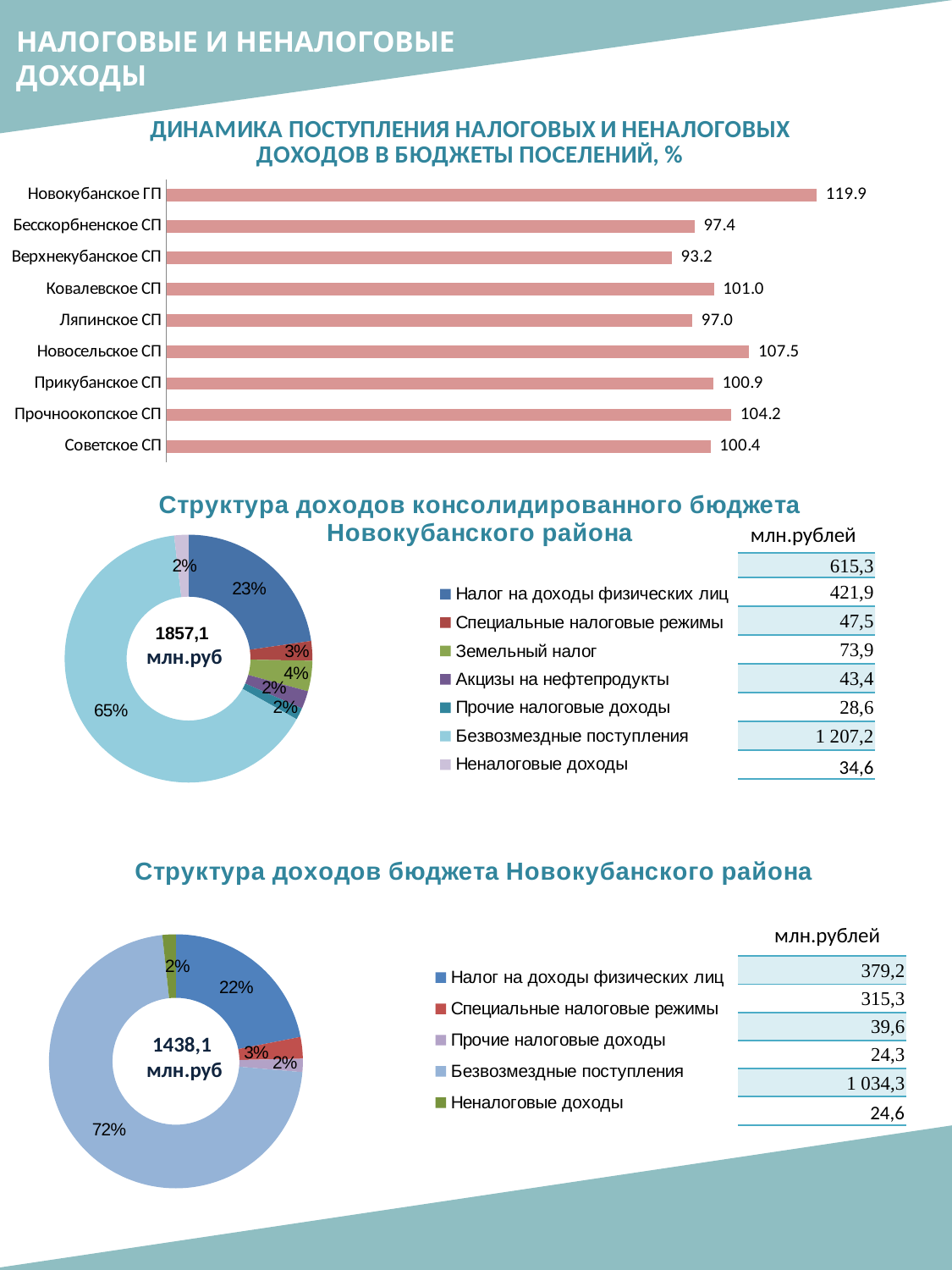
How many settlements are shown in the top bar chart? 9 In the top bar chart, which is larger: the value for Ковалевское СП or for Ляпинское СП? Ковалевское СП How many entries does the legend of the doughnut chart 'Структура доходов бюджета Новокубанского района' list? 5 In the doughnut chart 'Структура доходов бюджета Новокубанского района', what share do Безвозмездные поступления have? 72% What kind of chart is the top chart titled 'ДИНАМИКА ПОСТУПЛЕНИЯ НАЛОГОВЫХ И НЕНАЛОГОВЫХ ДОХОДОВ В БЮДЖЕТЫ ПОСЕЛЕНИЙ, %'? bar chart In the top bar chart, which settlement has the lowest value? Верхнекубанское СП In the top bar chart, what is the value for Новокубанское ГП? 119.9 In the top bar chart, what is the difference between the values for Новосельское СП and Прочноокопское СП? 3.3 What total value is shown in the centre of the doughnut chart 'Структура доходов бюджета Новокубанского района'? 1438,1 млн.руб How many entries does the legend of the doughnut chart 'Структура доходов консолидированного бюджета Новокубанского района' list? 7 In the top bar chart, which settlement has the highest value? Новокубанское ГП In the doughnut chart 'Структура доходов консолидированного бюджета Новокубанского района', what share do Безвозмездные поступления have? 65%